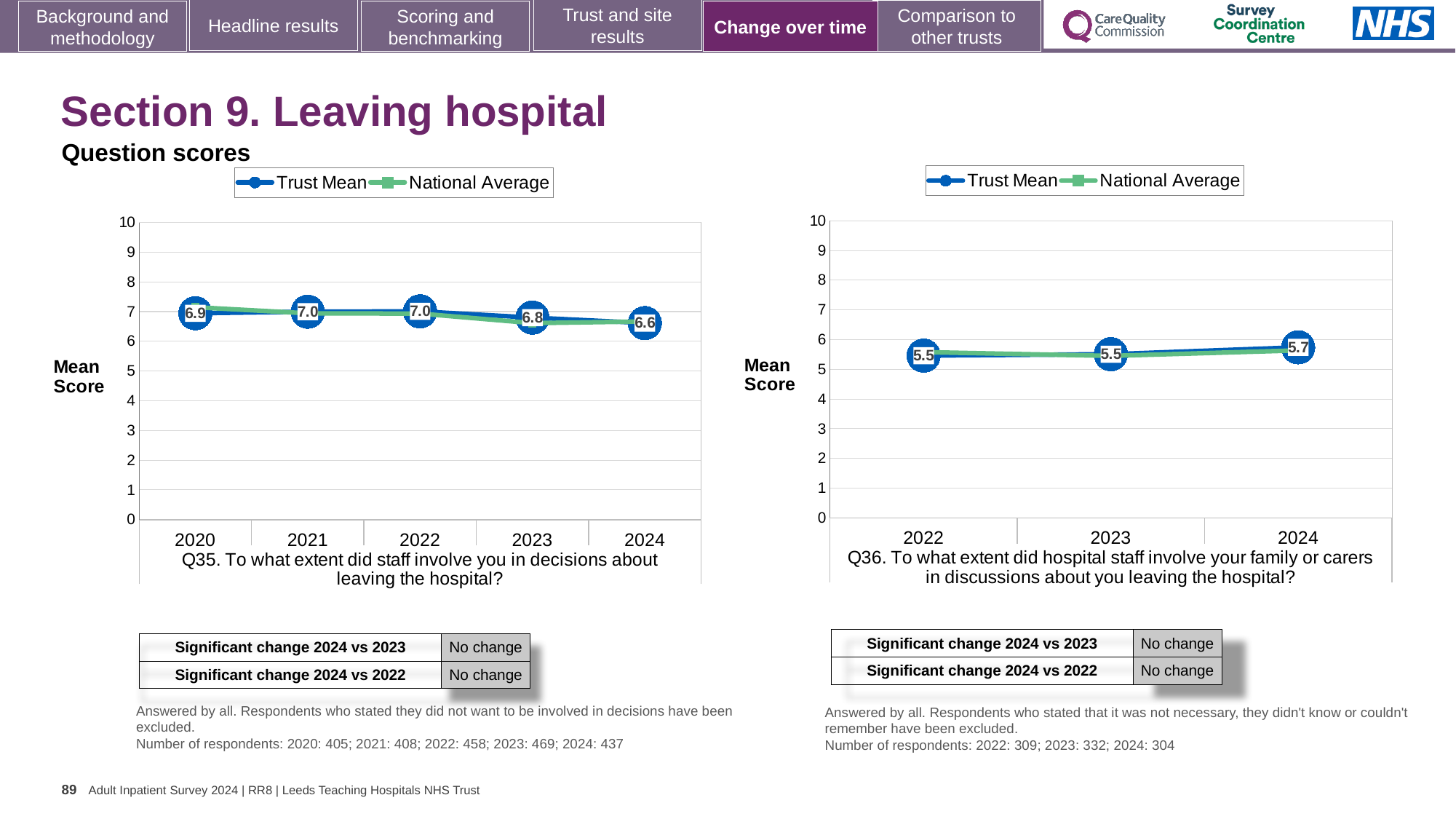
In the Q36 chart on the right, which year has the highest Trust Mean score? 2024 In the Q36 chart on the right, what is the Trust Mean score for 2022? 5.5 In the Q35 chart on the left, what is the Trust Mean score for 2024? 6.6 In the Q35 chart on the left, what is the difference between the Trust Mean scores for 2020 and 2024? 0.3 How many series does the legend of the Q36 chart on the right list? 2 In the Q36 chart on the right, is the National Average value for 2024 greater or less than 8? less In the Q35 chart on the left, which year has the lowest Trust Mean score? 2024 In the Q35 chart on the left, which year has the larger Trust Mean score, 2021 or 2024? 2021 What type of chart is the Q35 chart on the left? Line chart How many years are plotted in the Q35 chart on the left? 5 In the Q35 chart on the left, does the Trust Mean score rise or fall from 2022 to 2024? Fall In the Q36 chart on the right, what is the difference between the Trust Mean scores for 2022 and 2024? 0.2